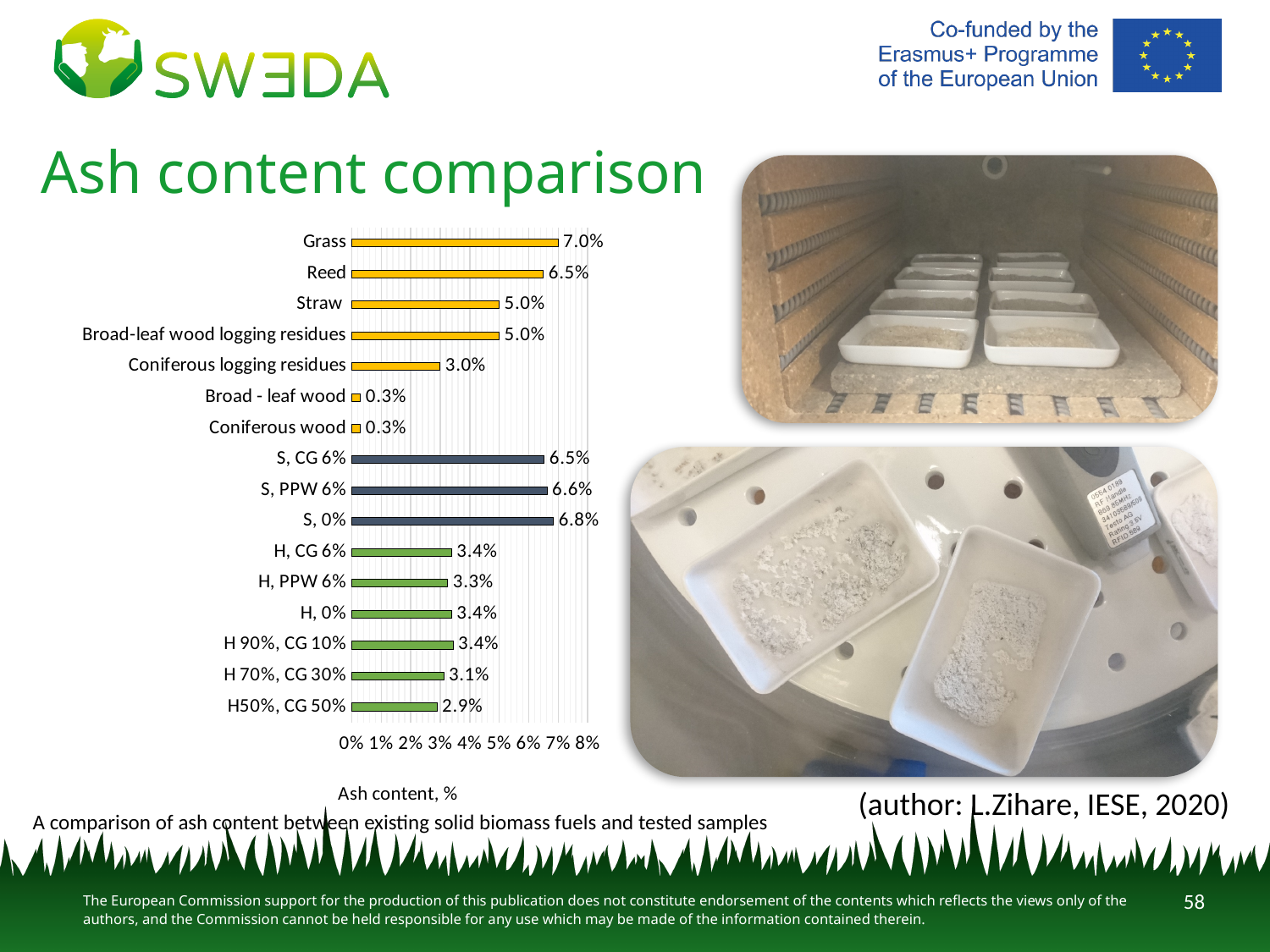
What is the ash content value shown for Coniferous logging residues? 3.0% What is the difference in ash content between Grass and Reed? 0.5% Which category has the highest ash content in the chart? Grass Which has a higher ash content, Straw or Coniferous logging residues? Straw What is the axis title shown below the chart? Ash content, % What is the ash content value shown for Grass? 7.0% What is the ash content value shown for H50%, CG 50%? 2.9% What is the difference in ash content between S, 0% and H, 0%? 3.4% What type of chart is shown on the slide? Bar chart Which has a higher ash content, S, CG 6% or H, CG 6%? S, CG 6% How many categories are plotted in the chart? 16 What is the ash content value shown for S, PPW 6%? 6.6%